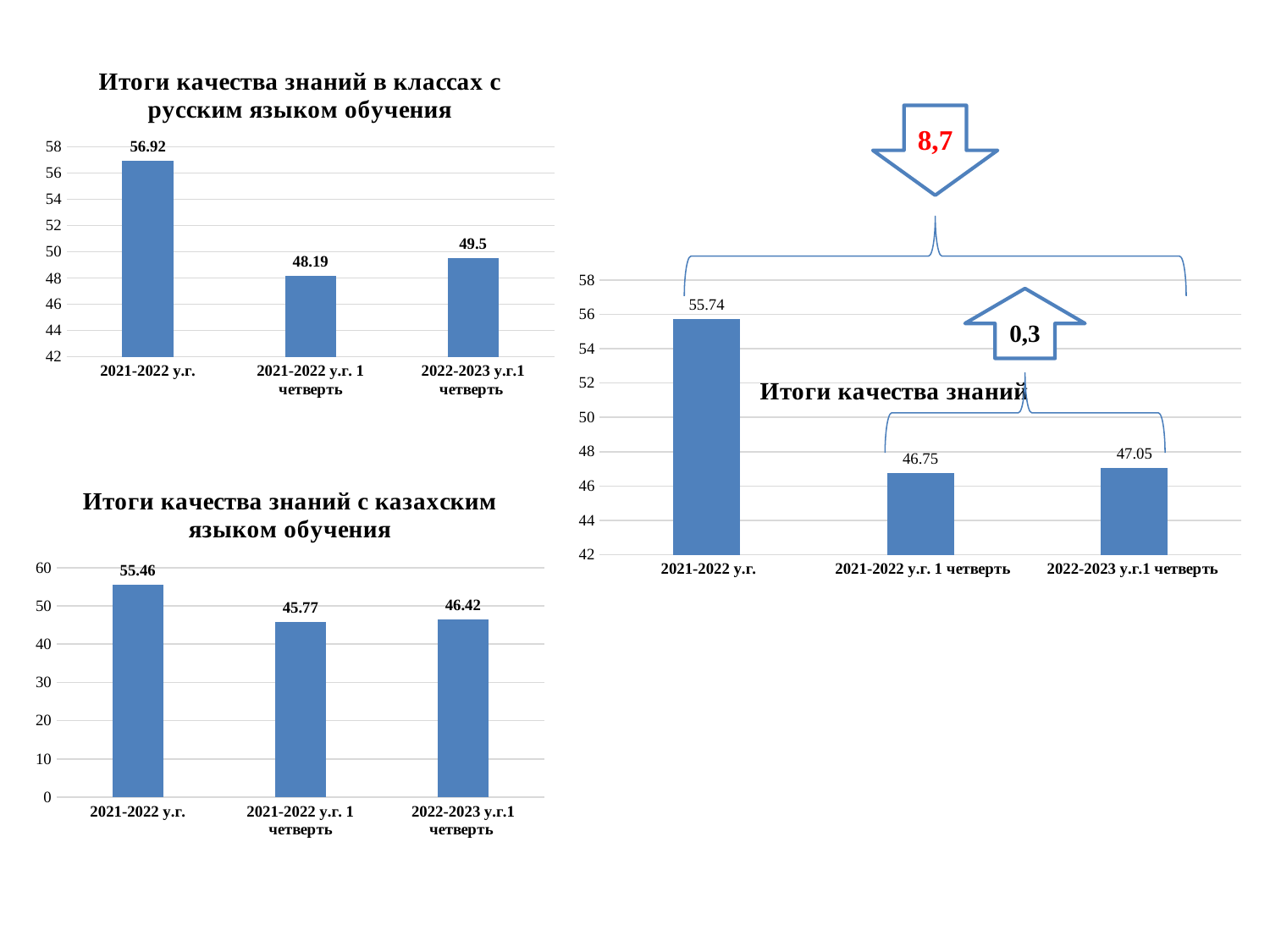
In the chart titled 'Итоги качества знаний' on the right, which is larger: the value for 2021-2022 у.г. 1 четверть or the value for 2022-2023 у.г.1 четверть? 2022-2023 у.г.1 четверть In the chart titled 'Итоги качества знаний с казахским языком обучения', what is the value for 2021-2022 у.г. 1 четверть? 45.77 In the chart titled 'Итоги качества знаний с казахским языком обучения', what is the difference between the values for 2021-2022 у.г. and 2022-2023 у.г.1 четверть? 9.04 In the chart titled 'Итоги качества знаний в классах с русским языком обучения', which category has the lowest value? 2021-2022 у.г. 1 четверть In the chart titled 'Итоги качества знаний' on the right, what is the value for 2021-2022 у.г.? 55.74 In the chart titled 'Итоги качества знаний с казахским языком обучения', which category has the highest value? 2021-2022 у.г. How many categories are shown in the chart titled 'Итоги качества знаний с казахским языком обучения'? 3 What type of chart is the chart titled 'Итоги качества знаний в классах с русским языком обучения'? Bar chart In the chart titled 'Итоги качества знаний' on the right, what is the value for 2022-2023 у.г.1 четверть? 47.05 In the chart titled 'Итоги качества знаний в классах с русским языком обучения', what is the value for 2021-2022 у.г.? 56.92 In the chart titled 'Итоги качества знаний в классах с русским языком обучения', what is the value for 2022-2023 у.г.1 четверть? 49.5 In the chart titled 'Итоги качества знаний' on the right, what is the difference between the values for 2021-2022 у.г. and 2021-2022 у.г. 1 четверть? 8.99